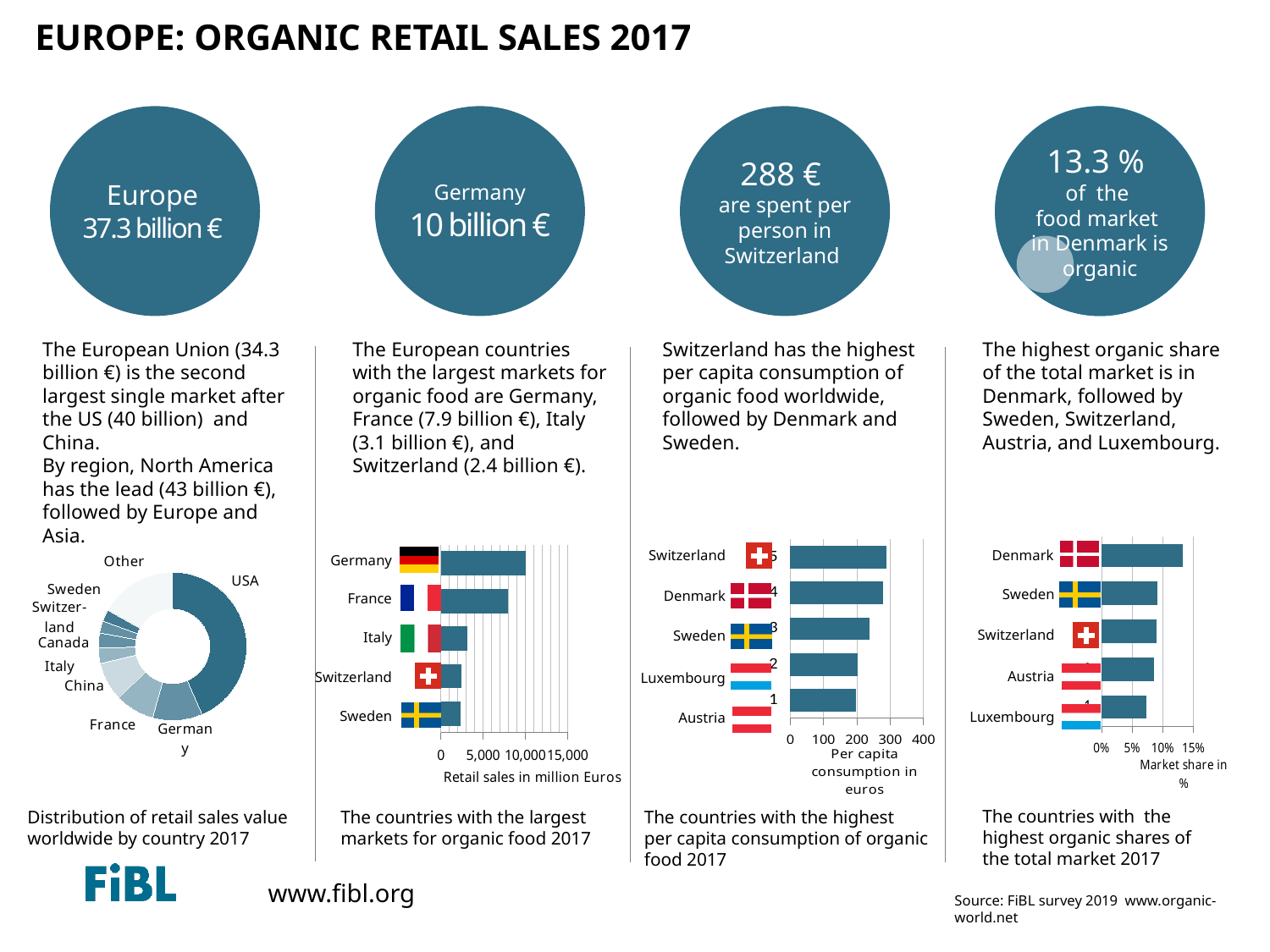
In 'The countries with the highest per capita consumption of organic food 2017' chart, which country has the highest per capita consumption? Switzerland In 'The countries with the highest per capita consumption of organic food 2017' chart, is the value for Austria greater or less than 300 euros? less In 'The countries with the highest organic shares of the total market 2017' chart, is the value for Luxembourg greater or less than 10%? less In the 'Distribution of retail sales value worldwide by country 2017' chart, which country has the largest slice? USA How many slices are shown in the 'Distribution of retail sales value worldwide by country 2017' chart? 9 What kind of chart is 'The countries with the largest markets for organic food 2017'? Bar chart In 'The countries with the highest organic shares of the total market 2017' chart, which country has the highest market share? Denmark What kind of chart is the 'Distribution of retail sales value worldwide by country 2017' chart? Donut (pie) chart In 'The countries with the largest markets for organic food 2017' chart, is the value for Italy greater or less than 5,000 million euros? less How many countries are shown in 'The countries with the largest markets for organic food 2017' chart? 5